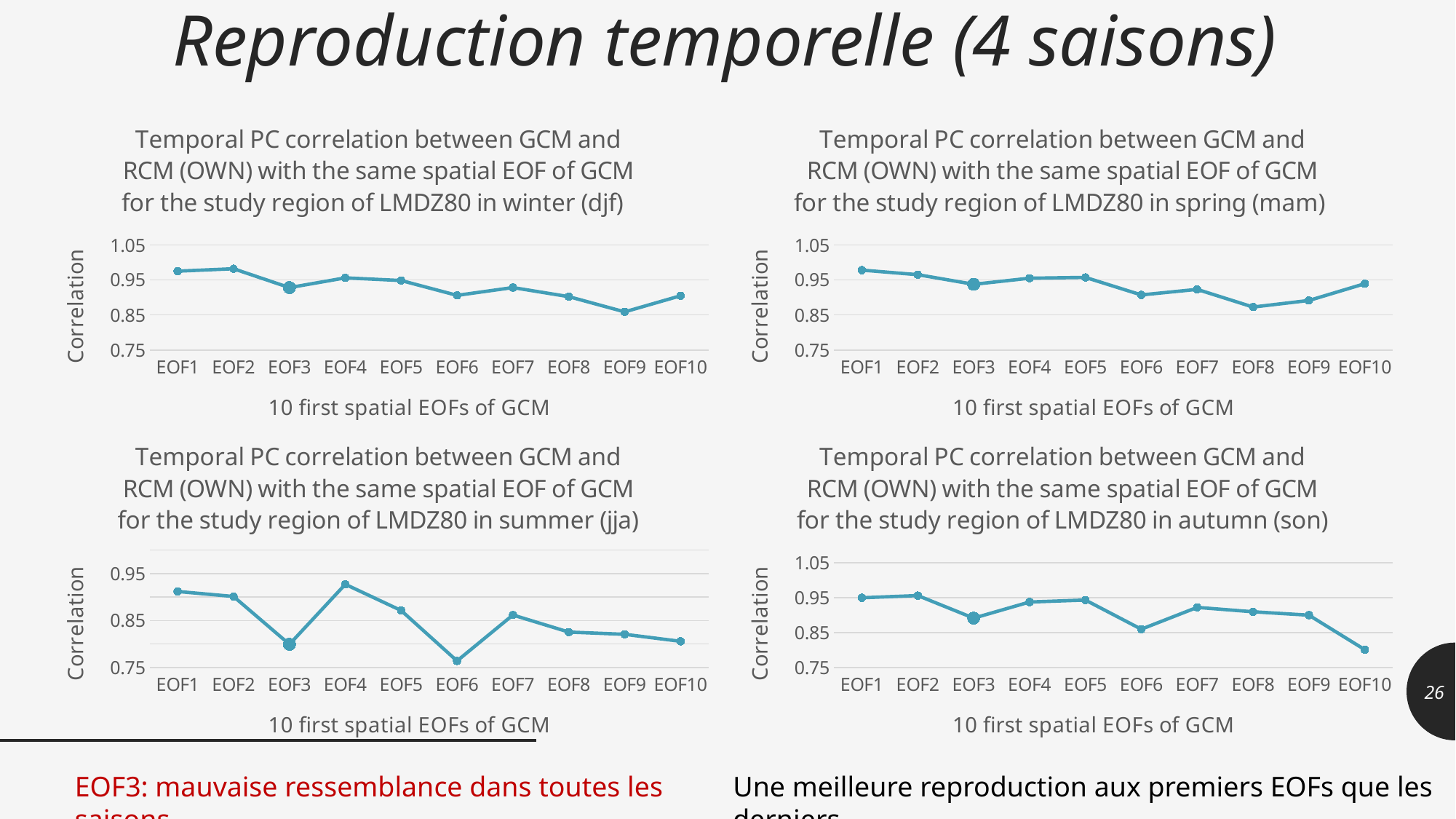
On the autumn (son) chart, which EOF has the lowest correlation? EOF10 On the autumn (son) chart, is the correlation for EOF10 greater or less than 0.85? less On the winter (djf) chart, which EOF has the lowest correlation? EOF9 On the spring (mam) chart, which EOF has the lowest correlation? EOF8 On the autumn (son) chart, is the correlation for EOF3 larger or smaller than the correlation for EOF2? smaller What is the x-axis label on the spring (mam) chart? 10 first spatial EOFs of GCM On the summer (jja) chart, which EOF has the highest correlation? EOF4 What kind of chart is the winter (djf) chart at the top left? line chart On the summer (jja) chart, is the correlation for EOF6 greater or less than 0.85? less How many EOF points are plotted on the summer (jja) chart? 10 On the winter (djf) chart, is the correlation for EOF1 greater or less than 0.95? greater